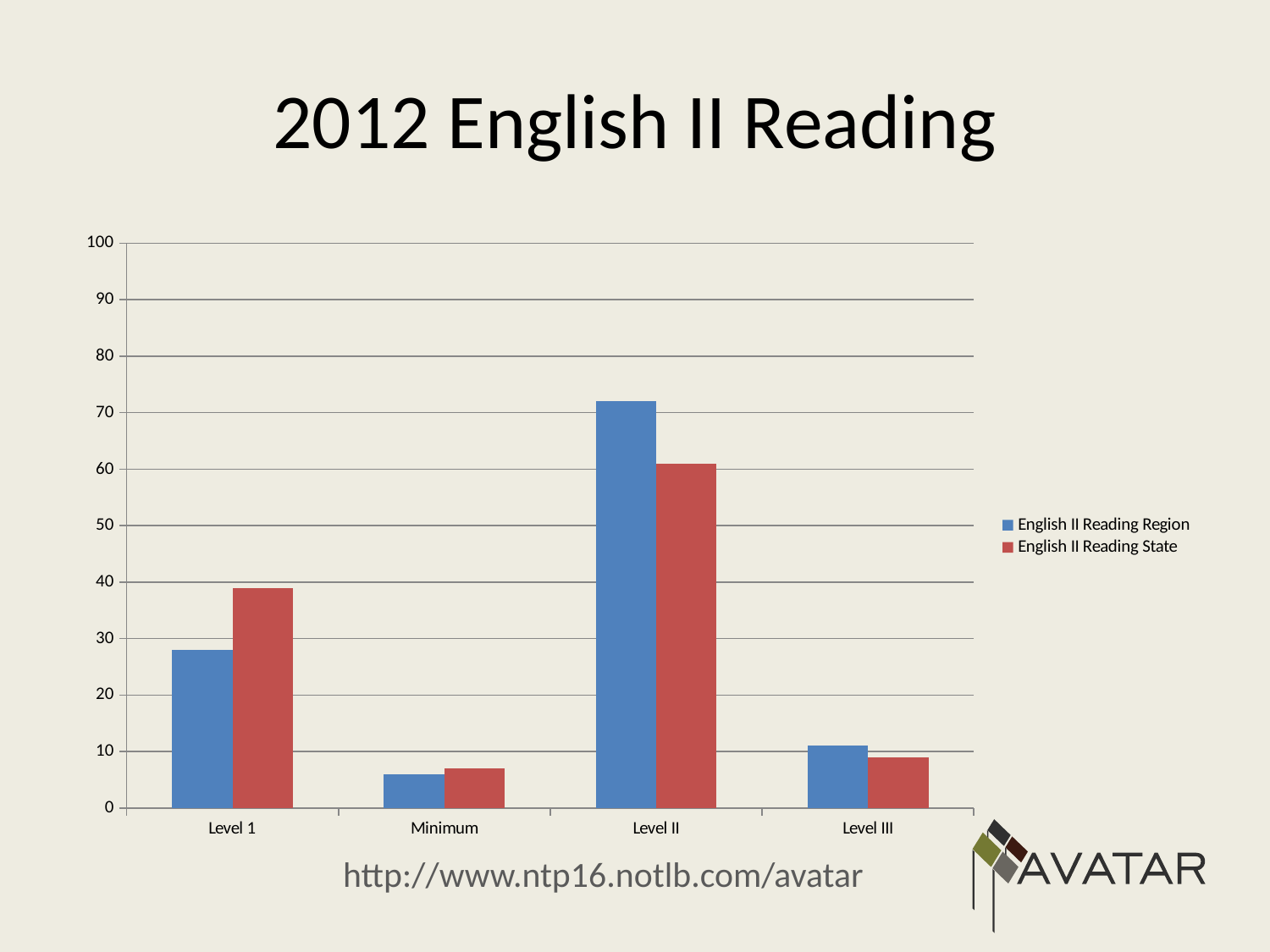
What is the title of the chart? 2012 English II Reading How many categories are shown on the x axis? 4 Is the value for English II Reading Region at Minimum greater or less than 10? less Is the value for English II Reading State at Level II greater or less than 50? greater For Level II, which series has the larger value, English II Reading Region or English II Reading State? English II Reading Region What kind of chart is shown on the slide? bar chart For Level 1, which series has the larger value, English II Reading Region or English II Reading State? English II Reading State Which category has the lowest value for English II Reading State? Minimum How many series does the legend list? 2 Which category has the highest value for English II Reading Region? Level II Is the value for English II Reading Region at Level II greater or less than 60? greater